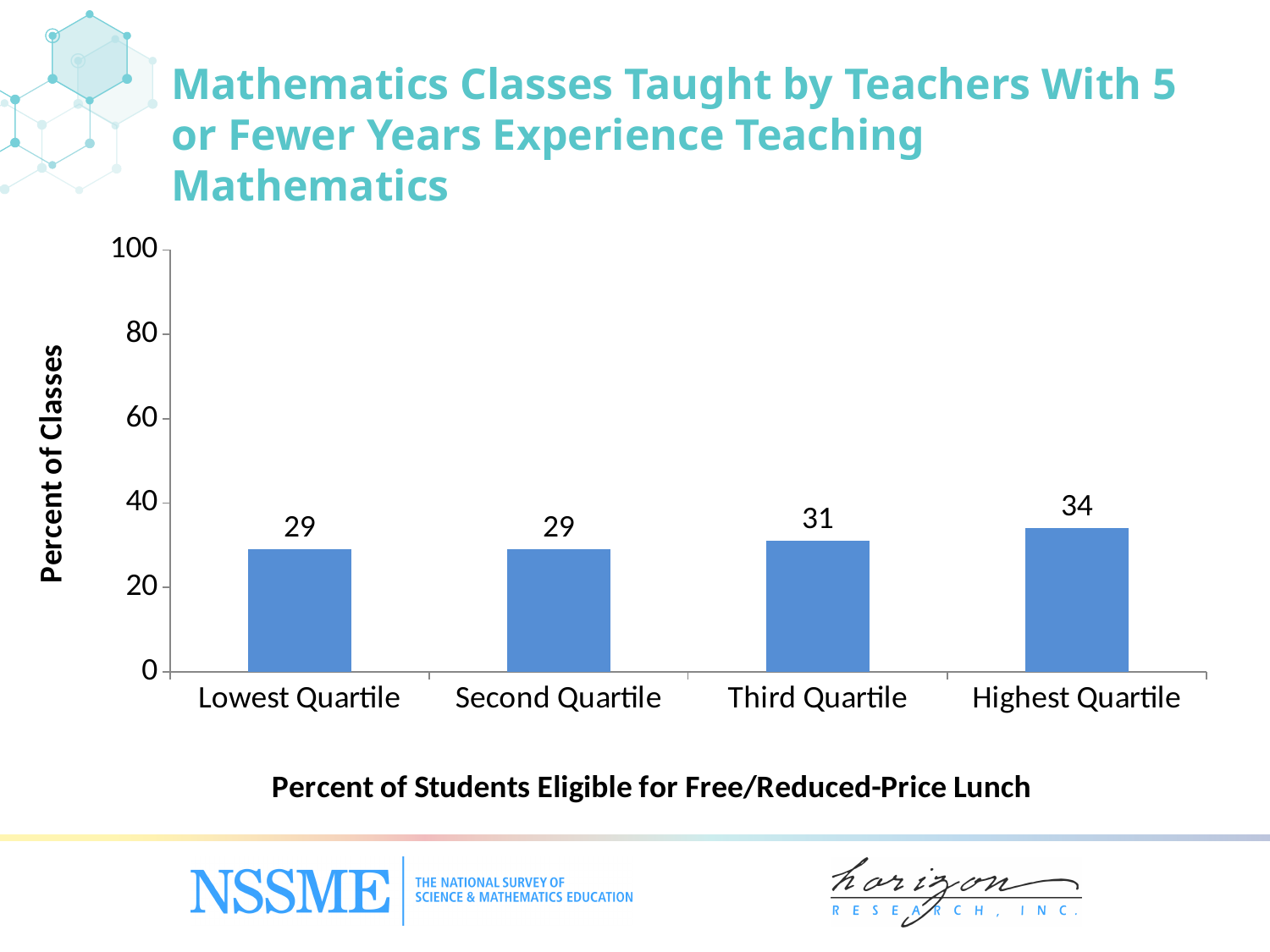
What is the difference between the Highest Quartile and the Lowest Quartile values? 5 What is the value for the Third Quartile? 31 What is the value for the Highest Quartile? 34 Do the values rise or fall from the Lowest Quartile to the Highest Quartile? rise How many categories are shown on the x axis? 4 What is the label of the y axis? Percent of Classes What kind of chart is shown on the slide? bar chart What is the difference between the Highest Quartile and the Third Quartile values? 3 Which is larger, the value for the Third Quartile or the value for the Second Quartile? Third Quartile Which category has the highest value? Highest Quartile Is the value for the Highest Quartile greater or less than 40? less What is the value for the Lowest Quartile? 29